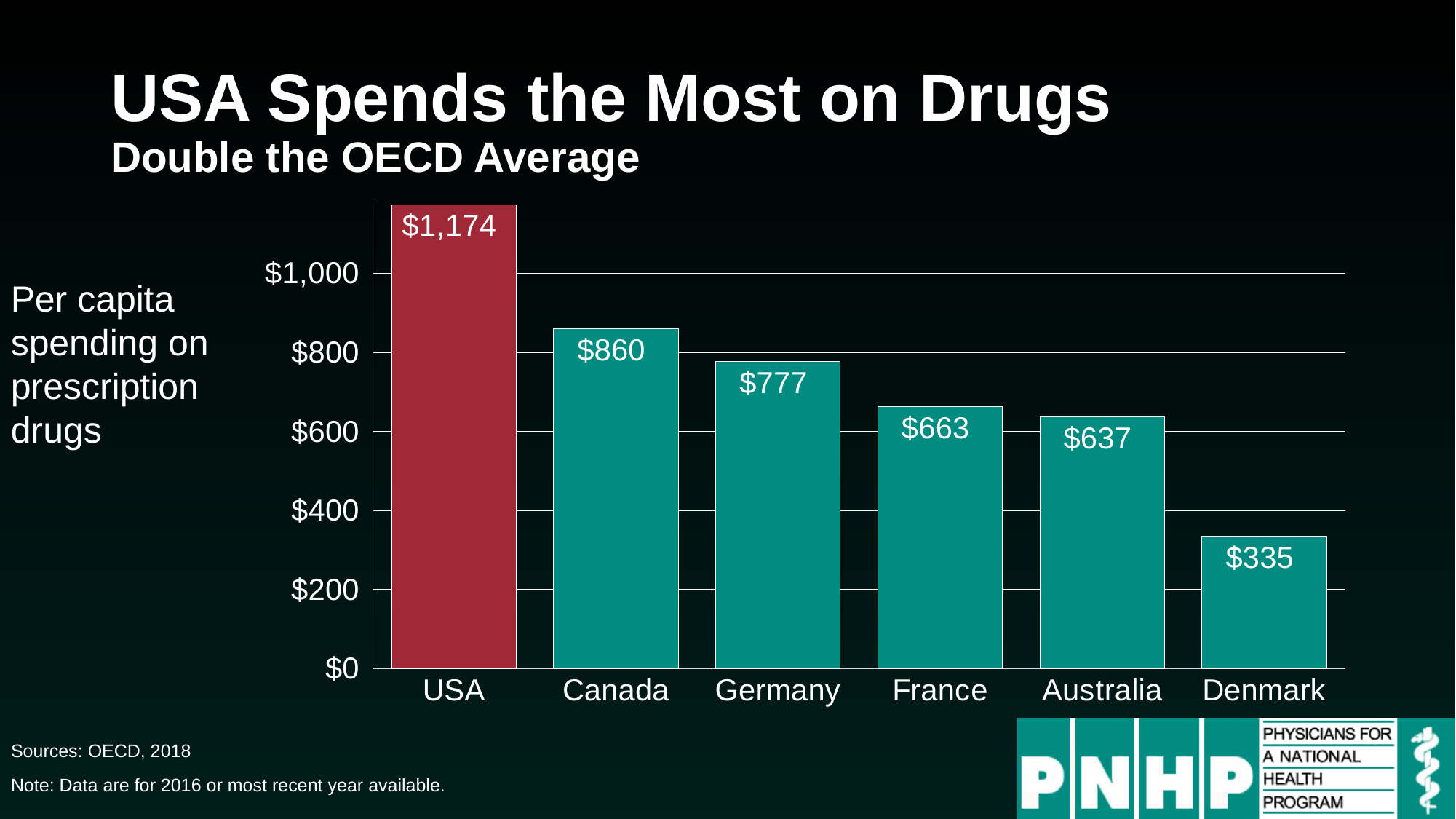
What kind of chart is shown on the slide? Bar chart Which country has the lowest per capita spending on prescription drugs? Denmark Which bar is shown in a different colour (red) from the others? USA Is the value for Australia greater or less than $600? greater Which country spends more per capita on prescription drugs, Canada or Germany? Canada What is the difference in per capita prescription drug spending between the USA and Canada? $314 What is the per capita spending on prescription drugs for Germany? $777 What is the difference in per capita prescription drug spending between France and Australia? $26 What is the per capita spending on prescription drugs for the USA? $1,174 Which country has the highest per capita spending on prescription drugs? USA How many countries are shown in the chart? 6 What is the per capita spending on prescription drugs for Denmark? $335